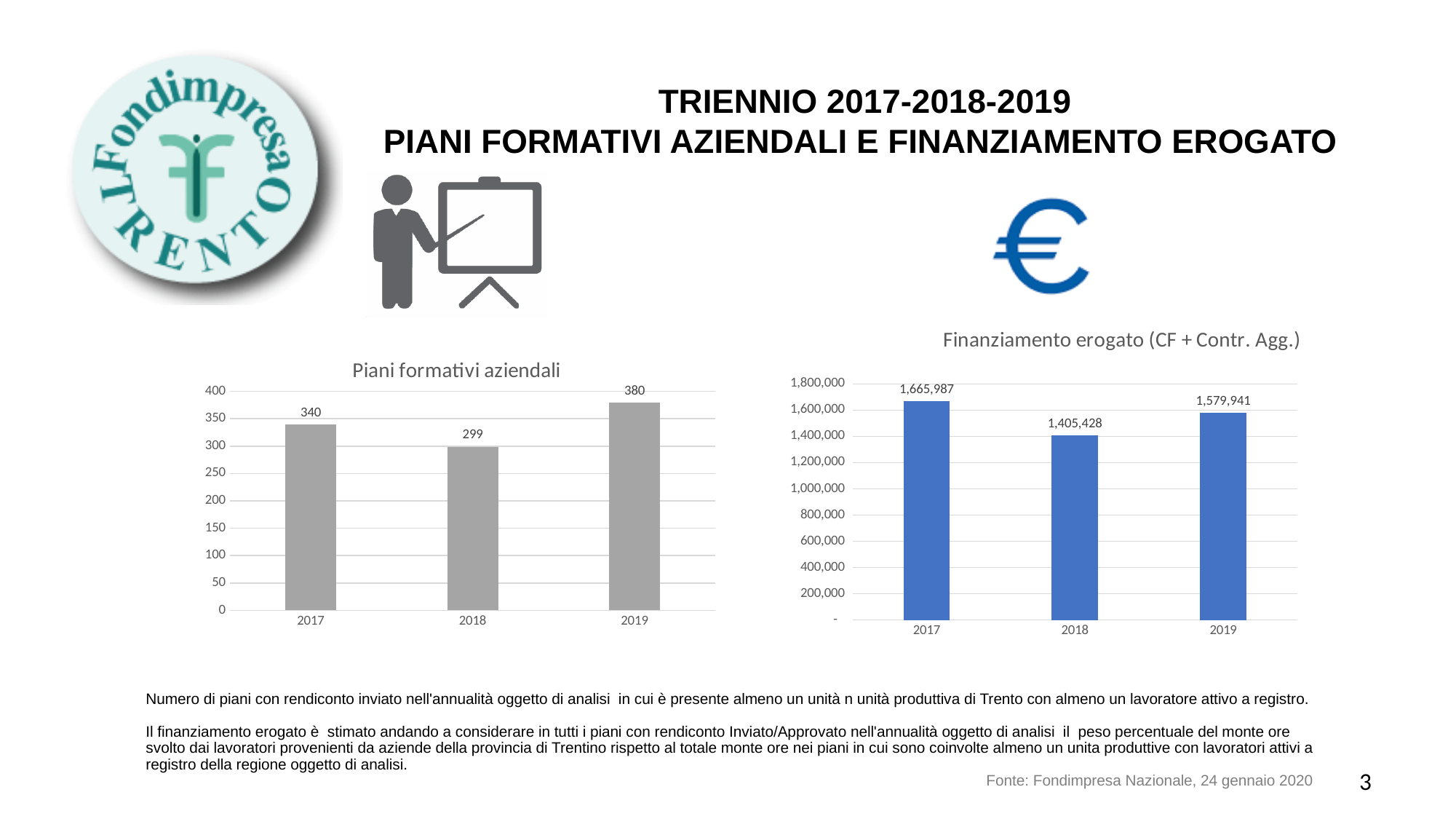
In the 'Piani formativi aziendali' chart, which year has the lowest value? 2018 In the 'Finanziamento erogato (CF + Contr. Agg.)' chart, what is the value for 2018? 1,405,428 In the 'Finanziamento erogato (CF + Contr. Agg.)' chart, what is the value for 2019? 1,579,941 In the 'Finanziamento erogato (CF + Contr. Agg.)' chart, which year has the highest value? 2017 In the 'Piani formativi aziendali' chart, what is the value for 2017? 340 In the 'Piani formativi aziendali' chart, how many years are shown on the x axis? 3 What kind of chart is 'Piani formativi aziendali'? bar chart In the 'Finanziamento erogato (CF + Contr. Agg.)' chart, what is the difference between the values for 2017 and 2018? 260,559 What colour are the bars in the 'Finanziamento erogato (CF + Contr. Agg.)' chart? blue In the 'Finanziamento erogato (CF + Contr. Agg.)' chart, is the value for 2018 greater or less than 1,600,000? less In the 'Piani formativi aziendali' chart, what is the difference between the values for 2019 and 2018? 81 In the 'Piani formativi aziendali' chart, which year has the highest value? 2019